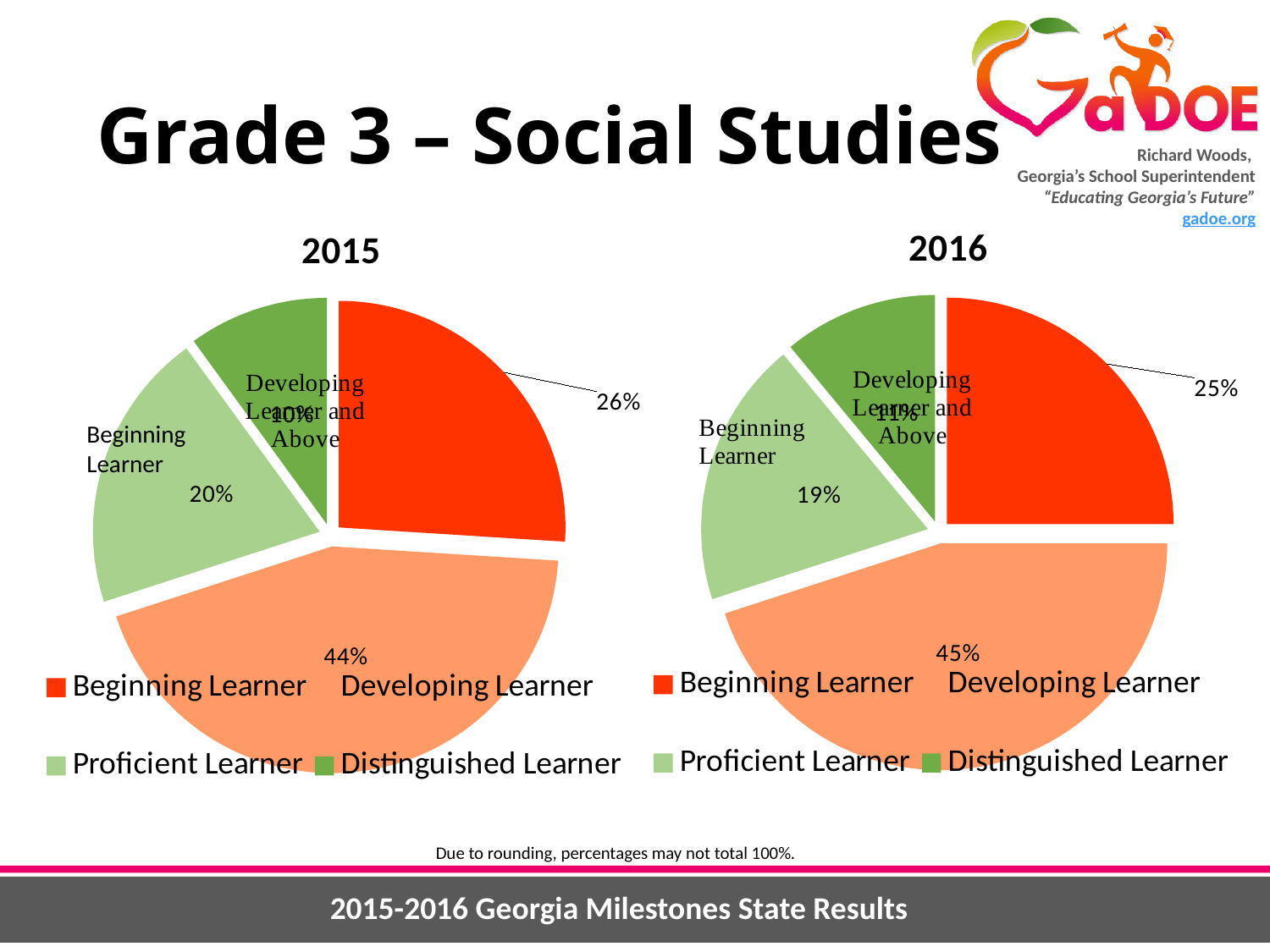
In the 2016 chart, what percentage is shown for Beginning Learner? 25% What kind of chart is the 2015 chart? pie chart In the 2015 chart, which category has the largest slice? Developing Learner In the 2016 chart, which category has the smallest slice? Distinguished Learner Which is larger in the 2015 chart: the Beginning Learner slice or the Proficient Learner slice? Beginning Learner What is the title of the chart on the right? 2016 In the 2015 chart, what percentage is shown for Beginning Learner? 26% How many slices does the 2016 pie chart have? 4 In the 2016 chart, what percentage is shown for Proficient Learner? 19% In the 2015 chart, what percentage is shown for Developing Learner? 44% How many entries does the legend of the 2015 chart list? 4 What is the difference between the Developing Learner percentage in the 2016 chart and in the 2015 chart? 1%